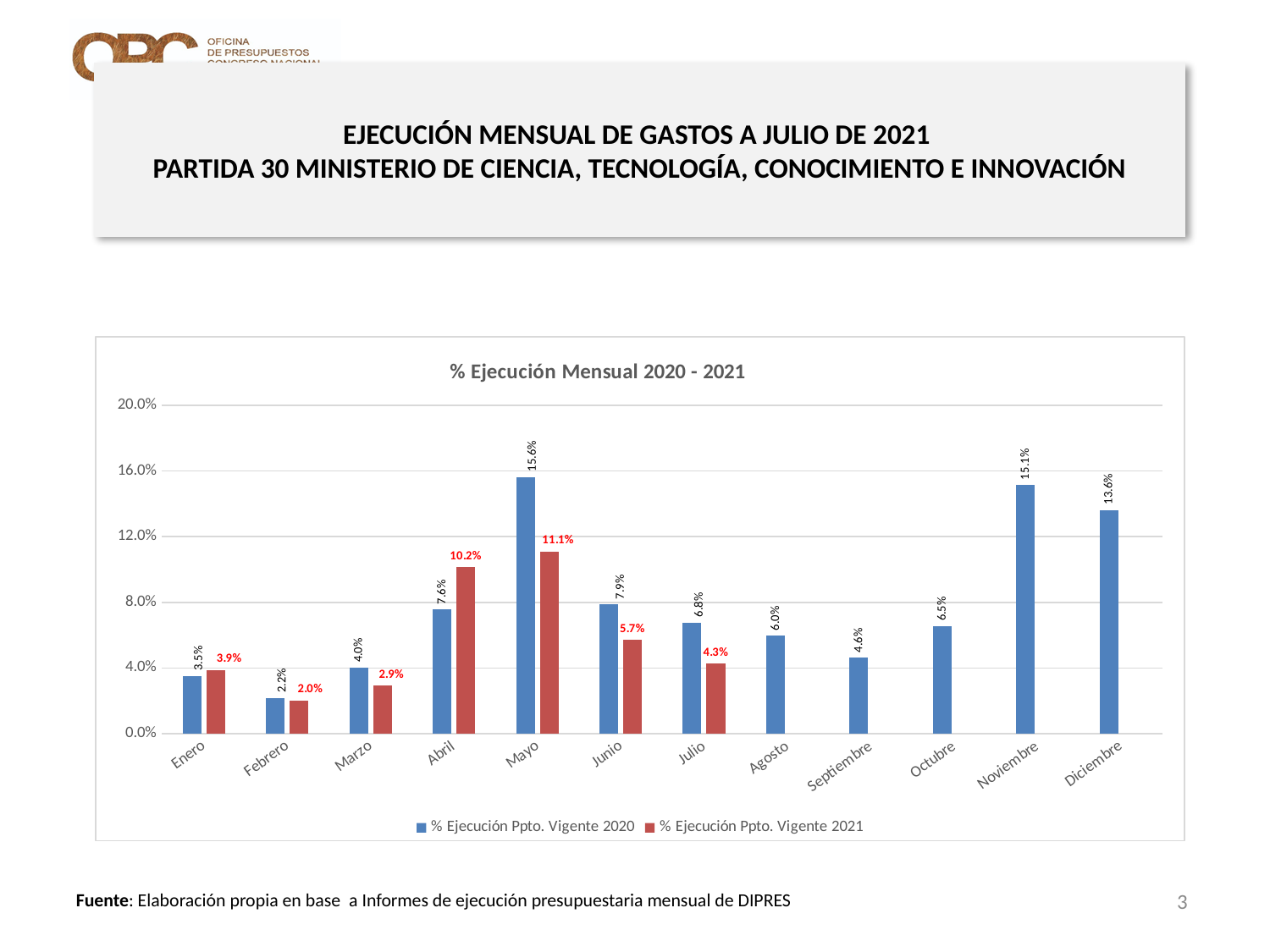
Which is larger for Junio: the % Ejecución Ppto. Vigente 2020 value or the 2021 value? % Ejecución Ppto. Vigente 2020 How many series does the legend list? 2 What is the value for Mayo in the % Ejecución Ppto. Vigente 2020 series? 15.6% What is the difference between the 2020 and 2021 values for Mayo? 4.5% Is the value for Noviembre in the 2020 series greater or less than 12.0%? greater What is the title of the chart? % Ejecución Mensual 2020 - 2021 Which month has the lowest value in the % Ejecución Ppto. Vigente 2021 series? Febrero How many months are shown on the x axis? 12 What kind of chart is shown on the slide? Bar chart What is the value for Julio in the % Ejecución Ppto. Vigente 2021 series? 4.3% What is the value for Abril in the % Ejecución Ppto. Vigente 2021 series? 10.2% Which month has the highest value in the % Ejecución Ppto. Vigente 2020 series? Mayo